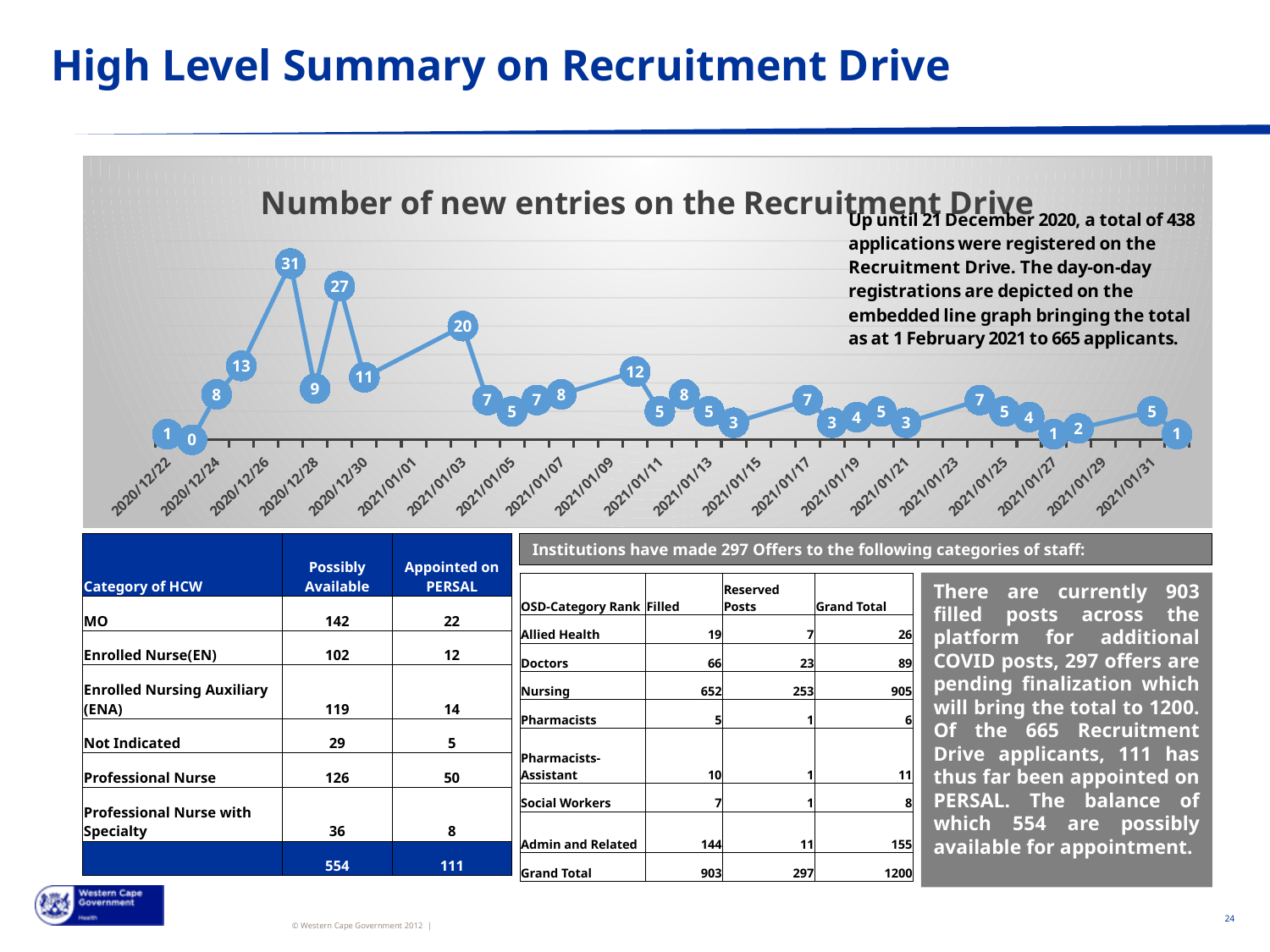
What is the title of the chart on the slide? Number of new entries on the Recruitment Drive What type of chart is shown on the slide? line chart What is the lowest value plotted on the line chart? 0 What is the highest value plotted on the line chart? 31 What is the value of the last plotted point on the line chart? 1 How many data points are plotted on the line chart? 30 What is the difference between the highest and lowest values plotted on the line chart? 31 What colour is the line on the chart? blue What is the value of the first plotted point on the line chart? 1 What is the second highest value plotted on the line chart? 27 Do the values on the line chart generally rise or fall from late December 2020 to the end of January 2021? fall What is the difference between the two highest values plotted on the line chart (31 and 27)? 4